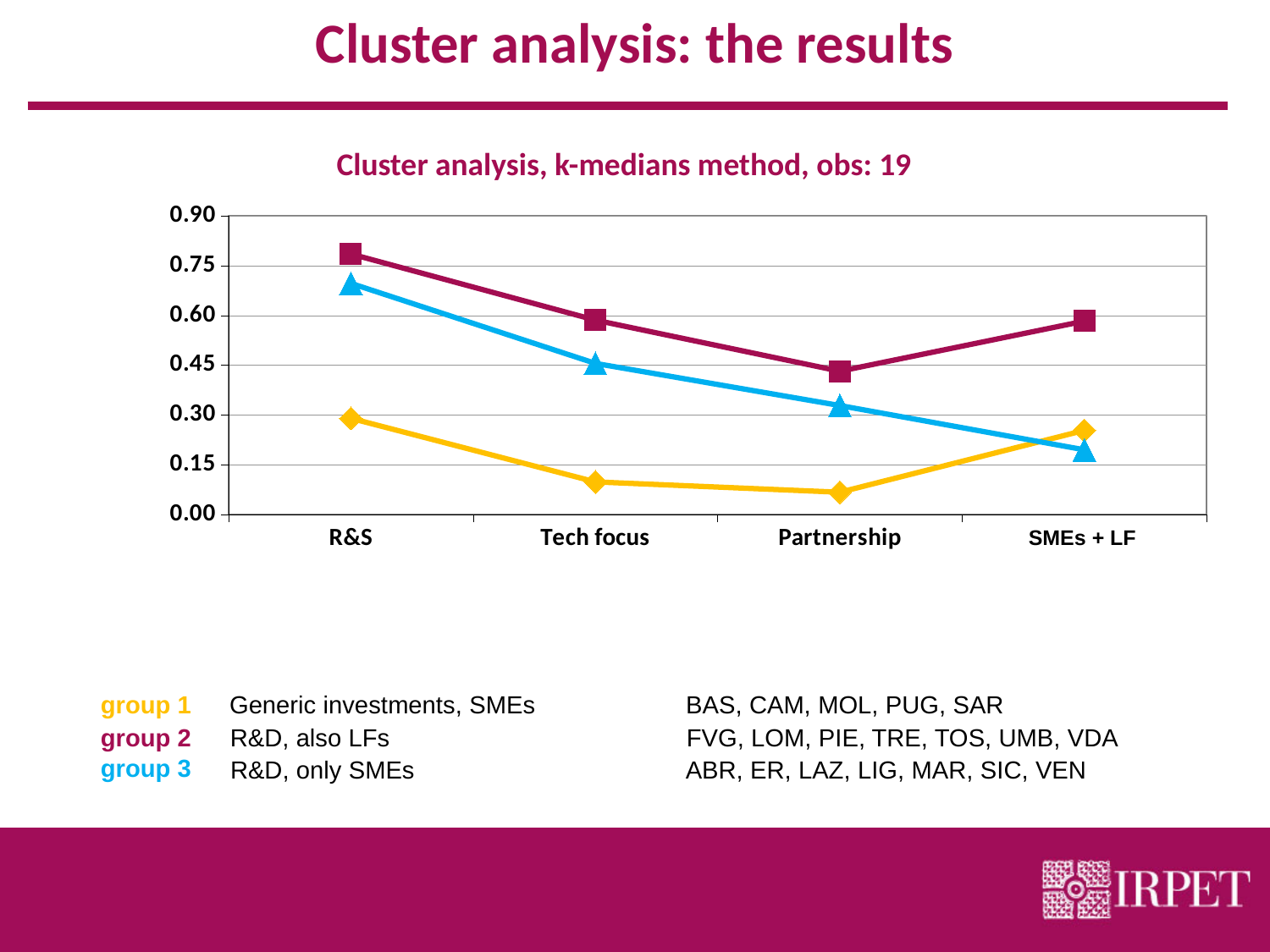
What is the title of the chart? Cluster analysis, k-medians method, obs: 19 At R&S, which line has the higher value: the magenta line with square markers or the blue line with triangle markers? the magenta line with square markers Is the value of the blue line with triangle markers at R&S greater or less than 0.75? less Is the value of the blue line with triangle markers at SMEs + LF greater or less than 0.30? less Does the blue line with triangle markers rise or fall from R&S to SMEs + LF? fall Is the value of the magenta line with square markers at SMEs + LF greater or less than 0.45? greater What kind of chart is shown on the slide? line chart At which category does the magenta line with square markers reach its highest value? R&S How many lines are plotted on the chart? 3 How many categories are shown on the x axis of the chart? 4 At which category does the yellow line with diamond markers reach its lowest value? Partnership